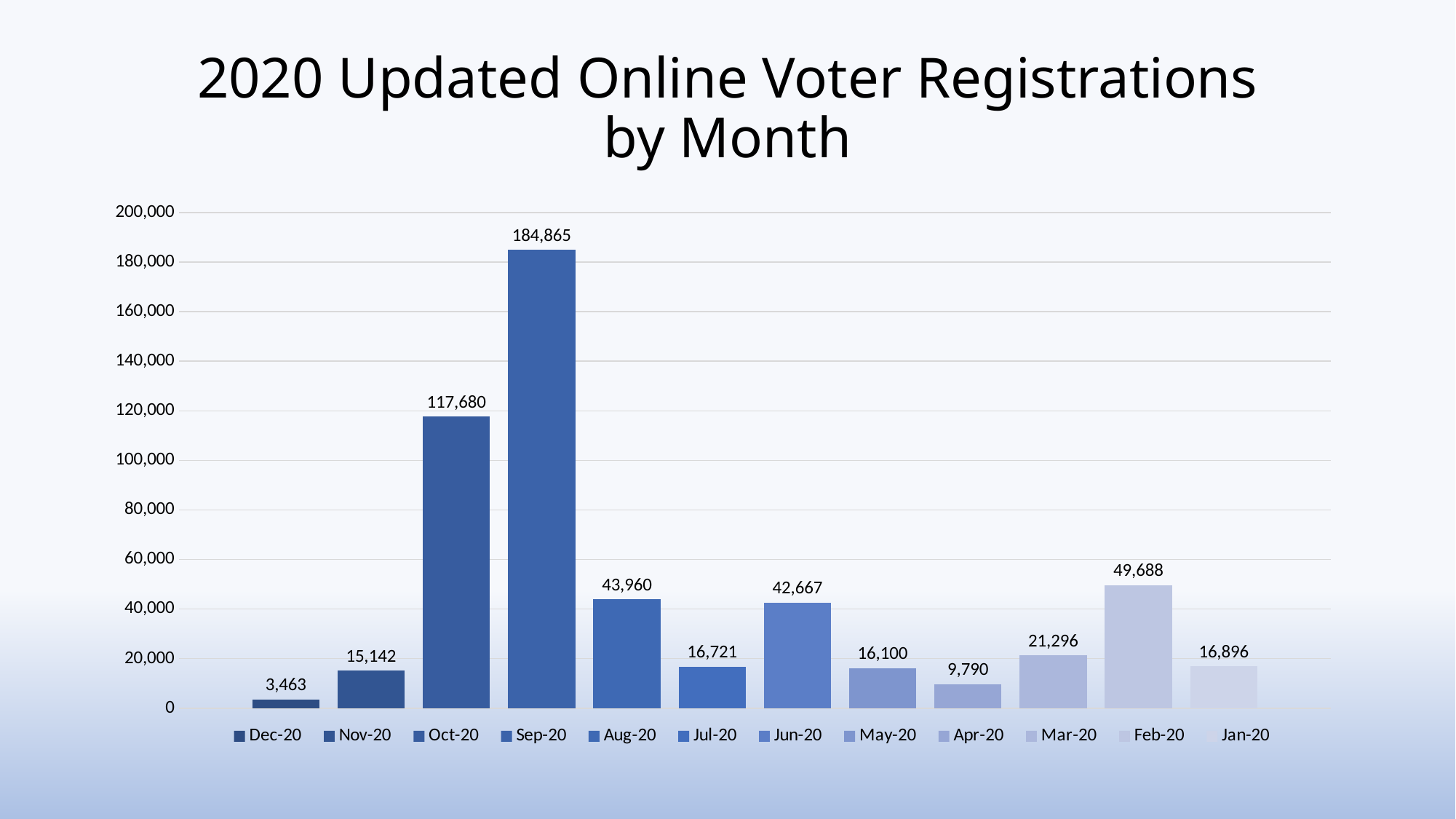
What is the title of the chart? 2020 Updated Online Voter Registrations by Month How many entries does the legend list? 12 Which is larger, the value for Feb-20 or the value for Aug-20? Feb-20 Which month has the highest value? Sep-20 What type of chart is shown on the slide? Bar chart What is the value for Feb-20? 49,688 What is the difference between the values for Sep-20 and Oct-20? 67,185 What is the value for Apr-20? 9,790 Which month has the lowest value? Dec-20 What is the value for Sep-20? 184,865 Is the value for Oct-20 greater or less than 100,000? greater How many bars (months) are plotted in the chart? 12